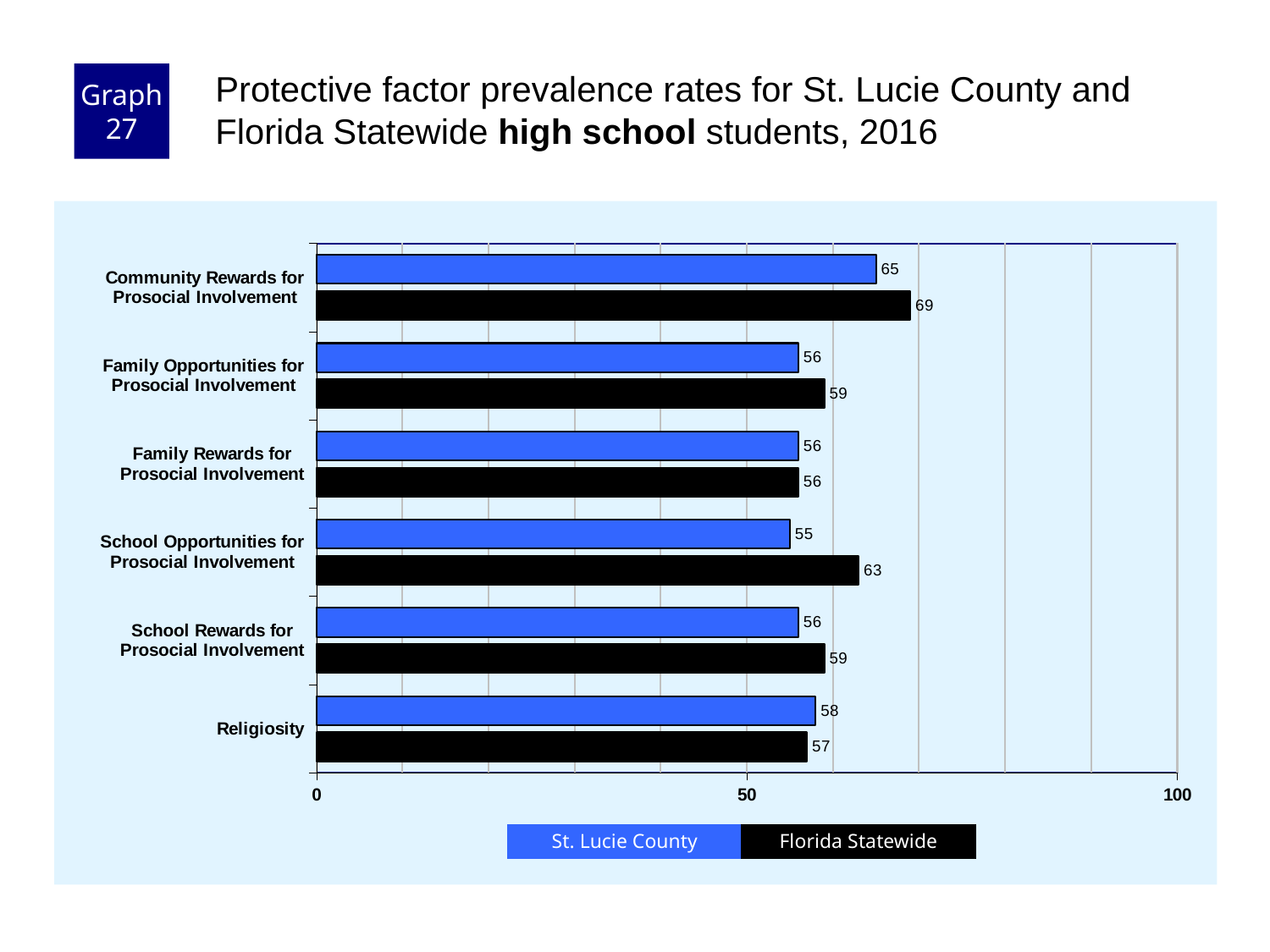
For Religiosity, which is larger: the St. Lucie County value or the Florida Statewide value? St. Lucie County What is the difference between the Florida Statewide and St. Lucie County values for Community Rewards for Prosocial Involvement? 4 Which category has the lowest St. Lucie County value? School Opportunities for Prosocial Involvement What is the Florida Statewide value for Religiosity? 57 What is the St. Lucie County value for Community Rewards for Prosocial Involvement? 65 What is the difference between the Florida Statewide and St. Lucie County values for School Opportunities for Prosocial Involvement? 8 What is the Florida Statewide value for School Opportunities for Prosocial Involvement? 63 How many categories are shown on the chart? 6 Is the Florida Statewide value for Community Rewards for Prosocial Involvement greater or less than 50? greater What kind of chart is shown on the slide? Bar chart How many series does the legend list? 2 Which category has the highest Florida Statewide value? Community Rewards for Prosocial Involvement